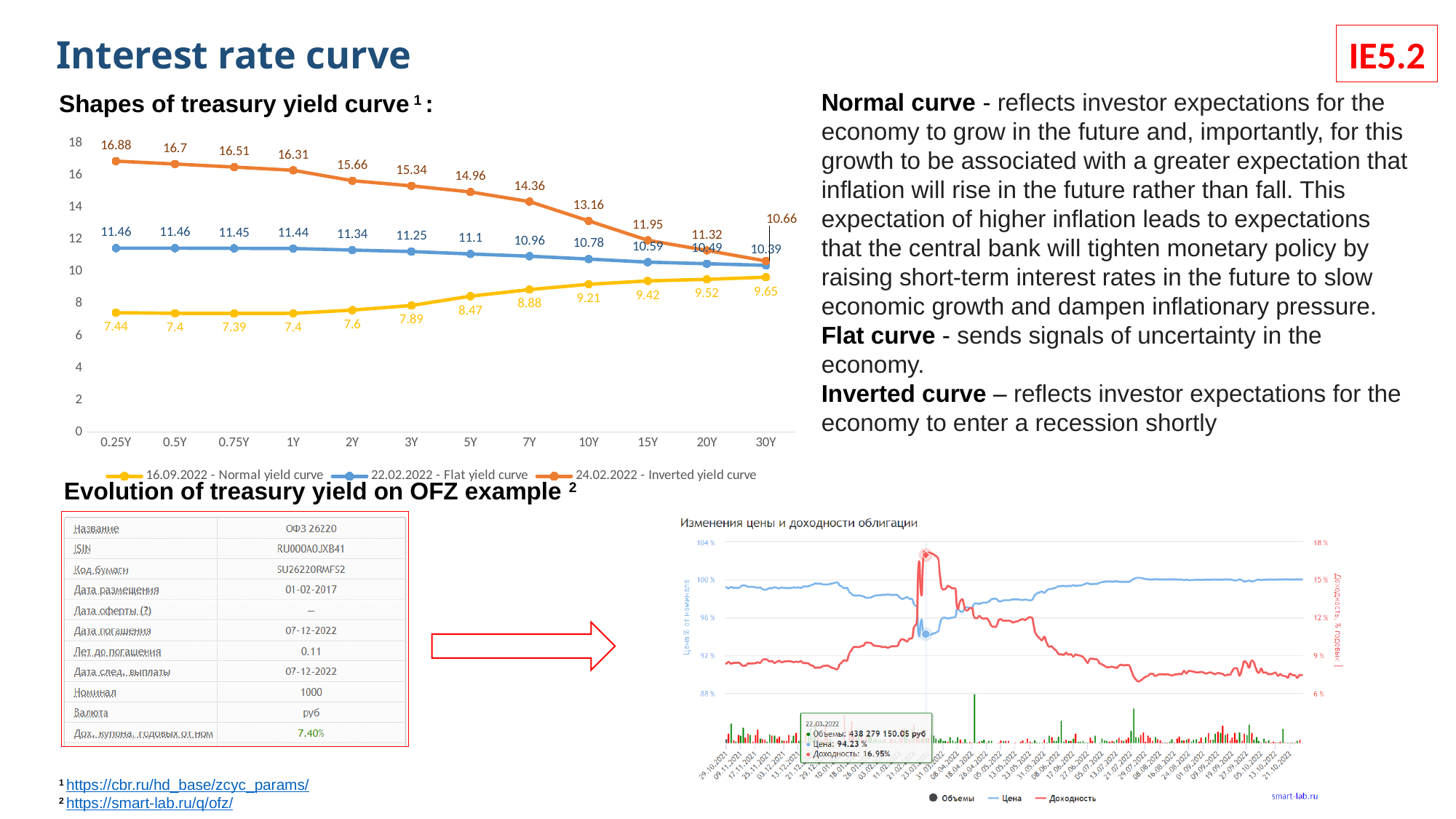
In the 'Shapes of treasury yield curve' chart, does the 24.02.2022 Inverted yield curve rise or fall as maturity increases from 0.25Y to 30Y? Fall How many series does the legend of the 'Shapes of treasury yield curve' chart list? 3 In the 'Shapes of treasury yield curve' chart, what is the value of the 16.09.2022 Normal yield curve at 0.25Y? 7.44 In the 'Shapes of treasury yield curve' chart, which colour is used for the 22.02.2022 Flat yield curve? Blue In the 'Shapes of treasury yield curve' chart, what is the value of the 22.02.2022 Flat yield curve at 30Y? 10.39 What type of chart is the 'Shapes of treasury yield curve' chart? Line chart In the 'Shapes of treasury yield curve' chart, what is the difference between the 24.02.2022 Inverted yield curve and the 16.09.2022 Normal yield curve at 0.25Y? 9.44 In the 'Shapes of treasury yield curve' chart, at which maturity is the 16.09.2022 Normal yield curve lowest? 0.75Y In the 'Shapes of treasury yield curve' chart, what is the value of the 24.02.2022 Inverted yield curve at 10Y? 13.16 In the 'Shapes of treasury yield curve' chart, at which maturity is the 24.02.2022 Inverted yield curve highest? 0.25Y How many maturity points are shown on the x axis of the 'Shapes of treasury yield curve' chart? 12 In the 'Shapes of treasury yield curve' chart, which is larger at 30Y: the 24.02.2022 Inverted yield curve or the 16.09.2022 Normal yield curve? 24.02.2022 - Inverted yield curve